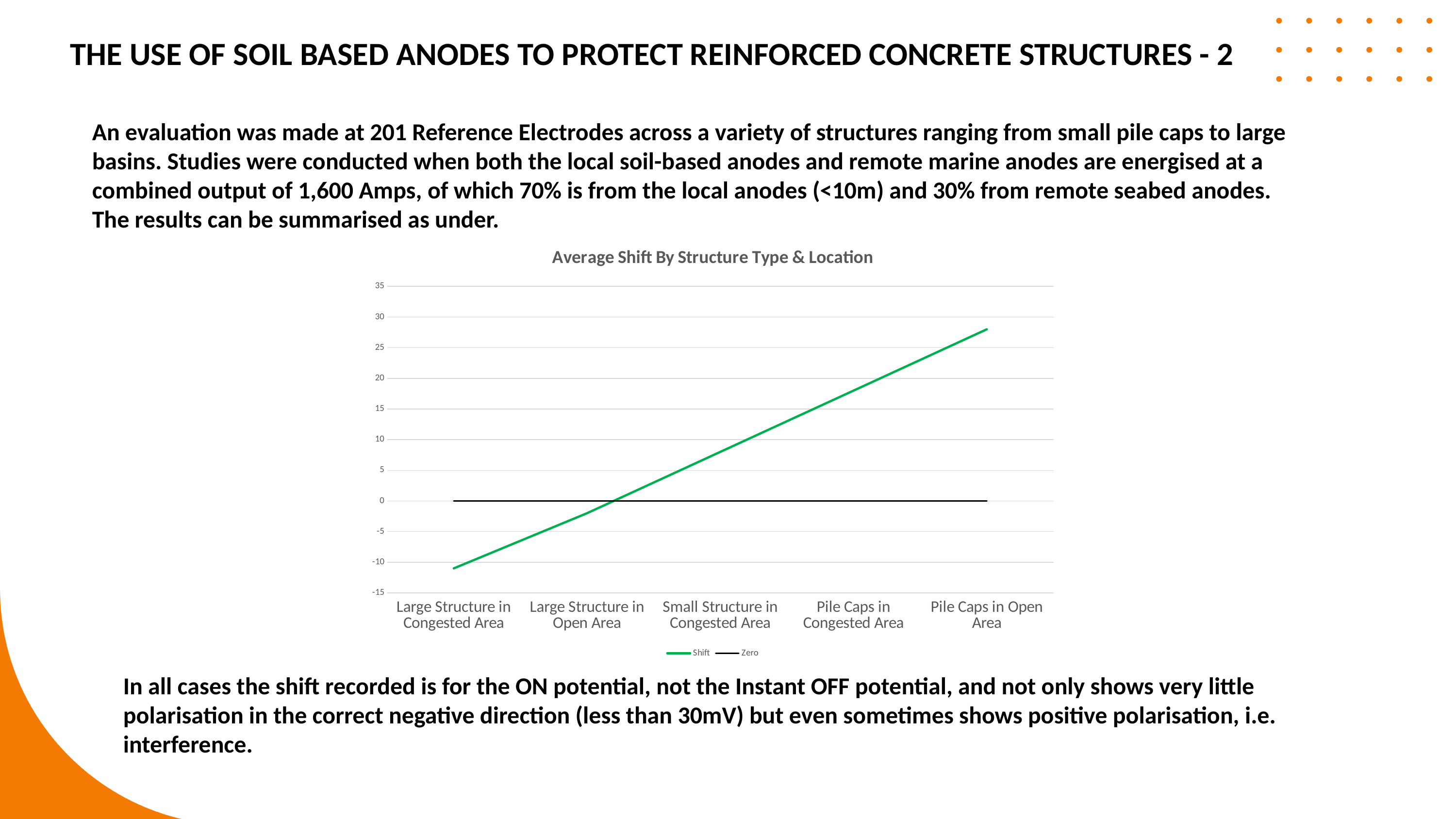
What is the title of the chart? Average Shift By Structure Type & Location Which category has the highest Shift value? Pile Caps in Open Area Is the Shift value for Pile Caps in Open Area greater or less than 25? greater How many categories are shown along the x axis of the chart? 5 Is the Shift value for Pile Caps in Congested Area greater or less than 15? greater How many series does the chart legend list? 2 What kind of chart is shown on the slide? line chart What colour is the Shift line in the chart? green Does the Shift line rise or fall from left to right across the categories? rise Is the Shift value for Large Structure in Congested Area greater or less than -5? less Which category has the lowest Shift value? Large Structure in Congested Area Which has the larger Shift value, Small Structure in Congested Area or Large Structure in Open Area? Small Structure in Congested Area